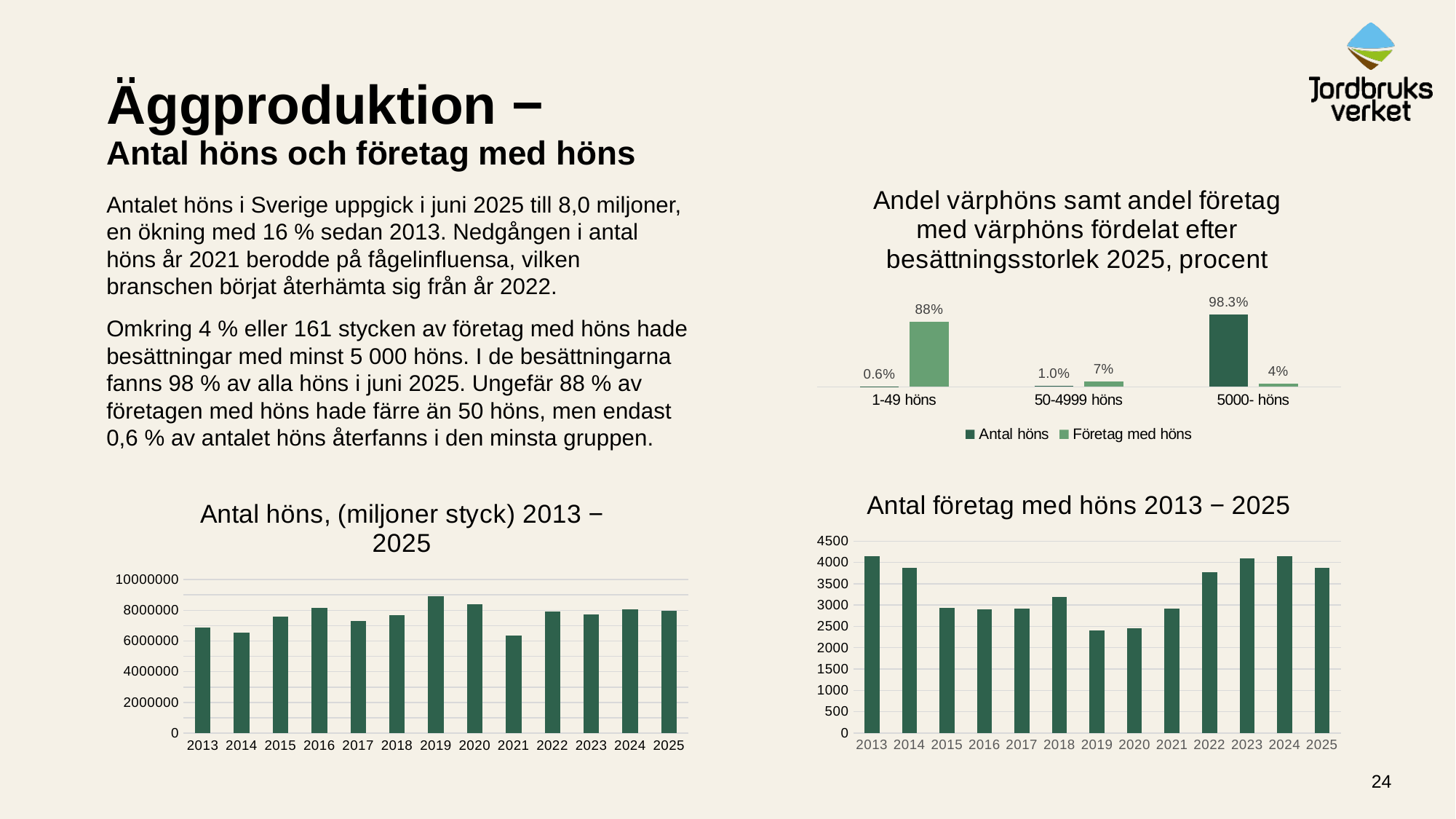
In the chart 'Andel värphöns samt andel företag med värphöns fördelat efter besättningsstorlek 2025, procent', what is the value of Antal höns for 5000- höns? 98.3% In the chart 'Antal höns, (miljoner styck) 2013 − 2025', is the value for 2019 greater or less than 8000000? greater In the chart 'Antal höns, (miljoner styck) 2013 − 2025', which year has the lowest value? 2021 In the chart 'Andel värphöns samt andel företag med värphöns fördelat efter besättningsstorlek 2025, procent', what is the difference between Antal höns for 5000- höns and Antal höns for 50-4999 höns? 97.3 percentage points In the chart 'Antal höns, (miljoner styck) 2013 − 2025', which year has the highest value? 2019 How many series does the legend list in the chart 'Andel värphöns samt andel företag med värphöns fördelat efter besättningsstorlek 2025, procent'? 2 How many years are shown on the x axis of the chart 'Antal höns, (miljoner styck) 2013 − 2025'? 13 In the chart 'Andel värphöns samt andel företag med värphöns fördelat efter besättningsstorlek 2025, procent', what is the value of Företag med höns for 1-49 höns? 88% In the chart 'Antal företag med höns 2013 − 2025', is the value for 2019 greater or less than 2500? less In the chart 'Antal företag med höns 2013 − 2025', which year has the larger value, 2013 or 2015? 2013 In the chart 'Andel värphöns samt andel företag med värphöns fördelat efter besättningsstorlek 2025, procent', which series is larger for 50-4999 höns, Antal höns or Företag med höns? Företag med höns What kind of chart is 'Antal höns, (miljoner styck) 2013 − 2025'? bar chart